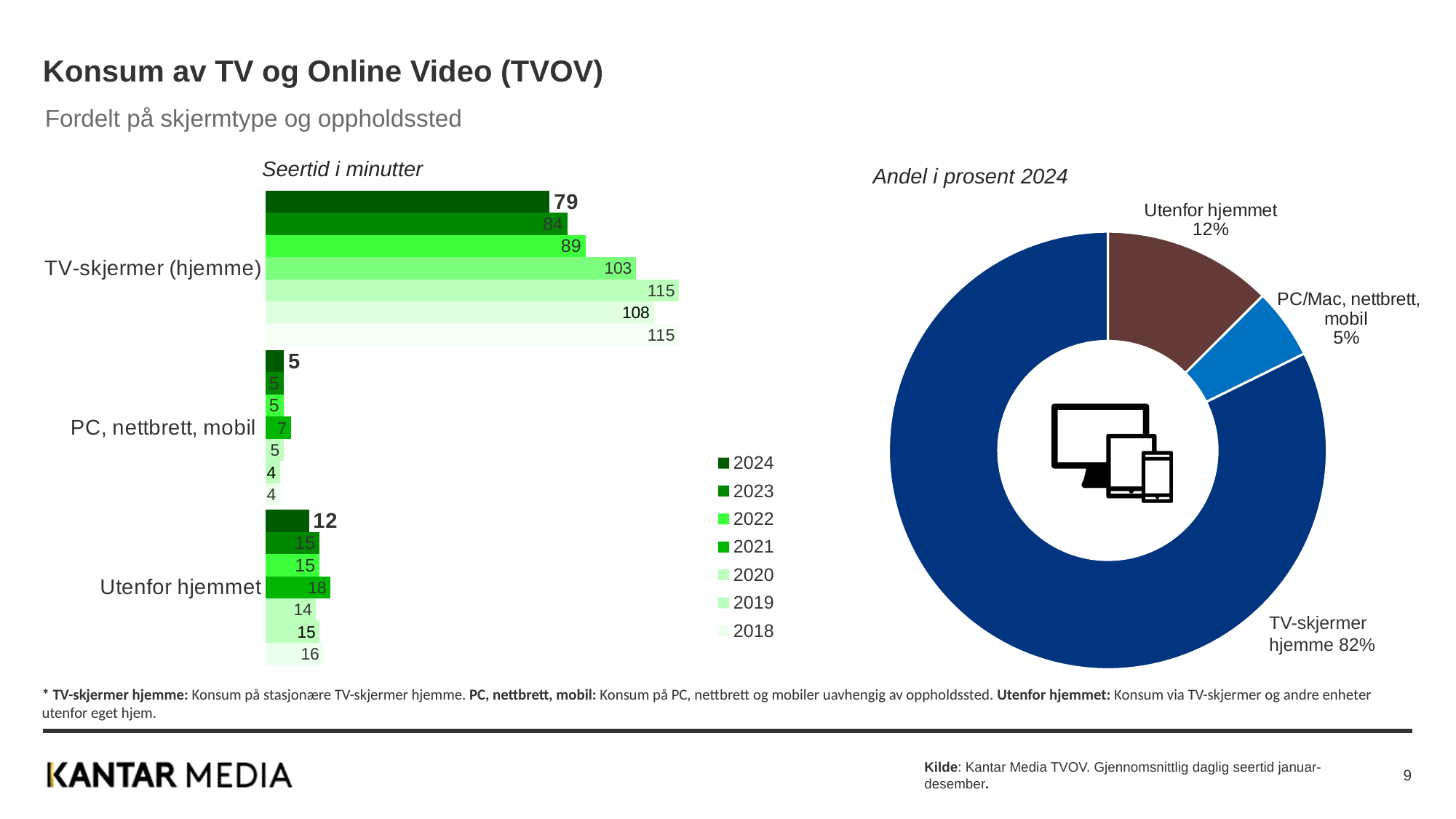
In the 'Seertid i minutter' bar chart, what is the value for TV-skjermer (hjemme) in 2024? 79 In the 'Seertid i minutter' bar chart, which year has the highest value for TV-skjermer (hjemme)? 2020 and 2018 (115) In the 'Seertid i minutter' bar chart, which is larger: Utenfor hjemmet in 2018 or in 2024? 2018 What kind of chart is 'Andel i prosent 2024'? Donut (pie) chart In the 'Seertid i minutter' bar chart, which year has the lowest value for TV-skjermer (hjemme)? 2024 In the 'Andel i prosent 2024' chart, which segment is the smallest? PC/Mac, nettbrett, mobil In the 'Seertid i minutter' bar chart, what is the difference between the TV-skjermer (hjemme) values for 2021 and 2024? 24 In the 'Andel i prosent 2024' chart, what share does TV-skjermer hjemme have? 82% In the 'Seertid i minutter' bar chart, what is the value for PC, nettbrett, mobil in 2018? 4 How many series does the legend of the 'Seertid i minutter' bar chart list? 7 In the 'Seertid i minutter' bar chart, what is the value for Utenfor hjemmet in 2021? 18 How many categories are shown in the 'Seertid i minutter' bar chart? 3